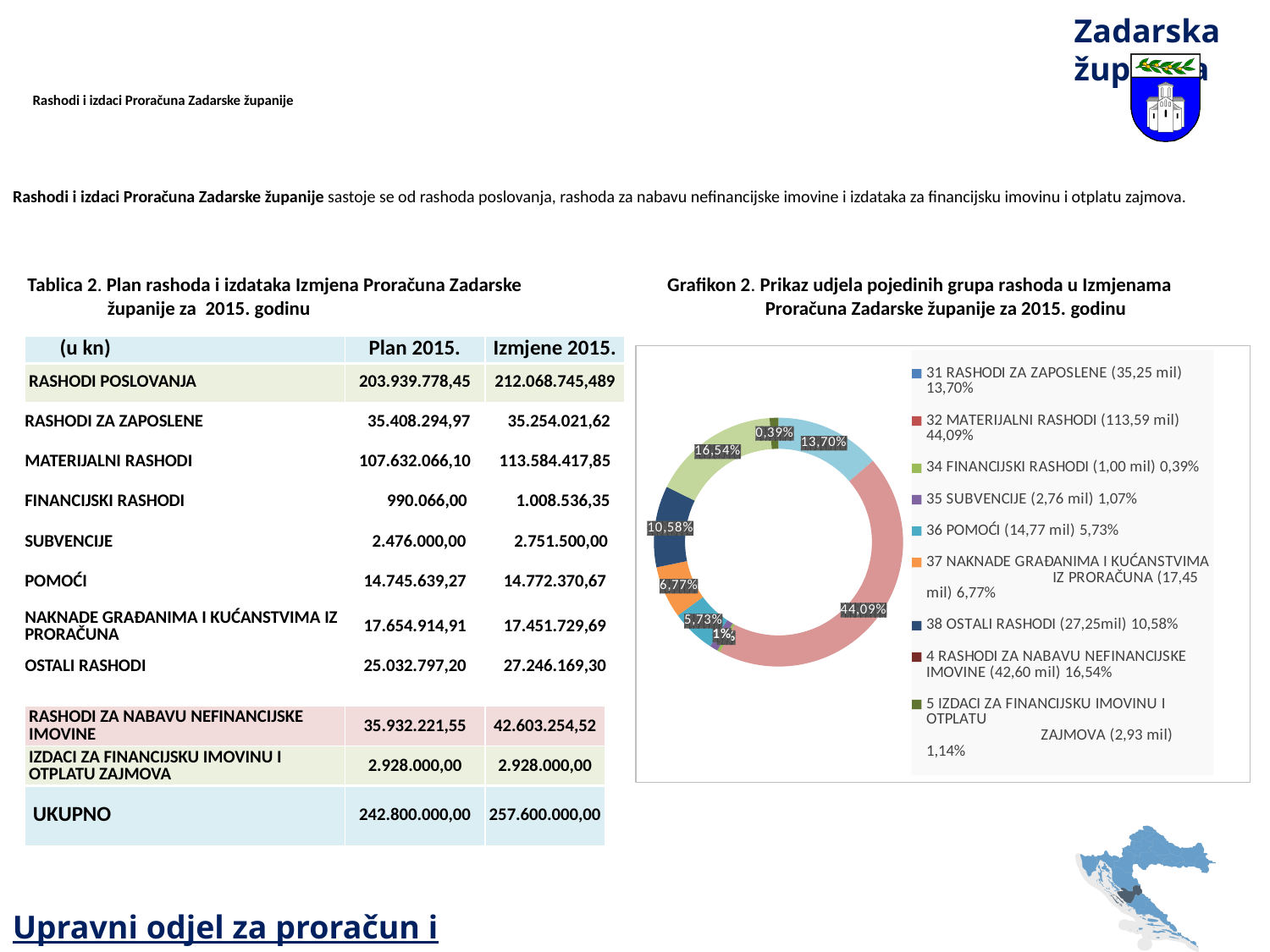
How many entries does the legend of Grafikon 2 list? 9 In Grafikon 2, what share does the legend give for 35 SUBVENCIJE? 1,07% In Grafikon 2, what share is shown for 32 MATERIJALNI RASHODI? 44,09% In Grafikon 2, which has the larger share: 36 POMOĆI or 37 NAKNADE GRAĐANIMA I KUĆANSTVIMA IZ PRORAČUNA? 37 NAKNADE GRAĐANIMA I KUĆANSTVIMA IZ PRORAČUNA In Grafikon 2, what share is shown for 38 OSTALI RASHODI? 10,58% Which group has the largest share in Grafikon 2? 32 MATERIJALNI RASHODI In Grafikon 2, what share is shown for 31 RASHODI ZA ZAPOSLENE? 13,70% In Grafikon 2, how many percentage points larger is the share of 32 MATERIJALNI RASHODI than that of 31 RASHODI ZA ZAPOSLENE? 30,39 percentage points Which group has the smallest share in Grafikon 2? 34 FINANCIJSKI RASHODI What kind of chart is Grafikon 2 on the slide? doughnut (pie) chart In Grafikon 2, what share is shown for 4 RASHODI ZA NABAVU NEFINANCIJSKE IMOVINE? 16,54% What is the title of the chart on the right side of the slide? Grafikon 2. Prikaz udjela pojedinih grupa rashoda u Izmjenama Proračuna Zadarske županije za 2015. godinu